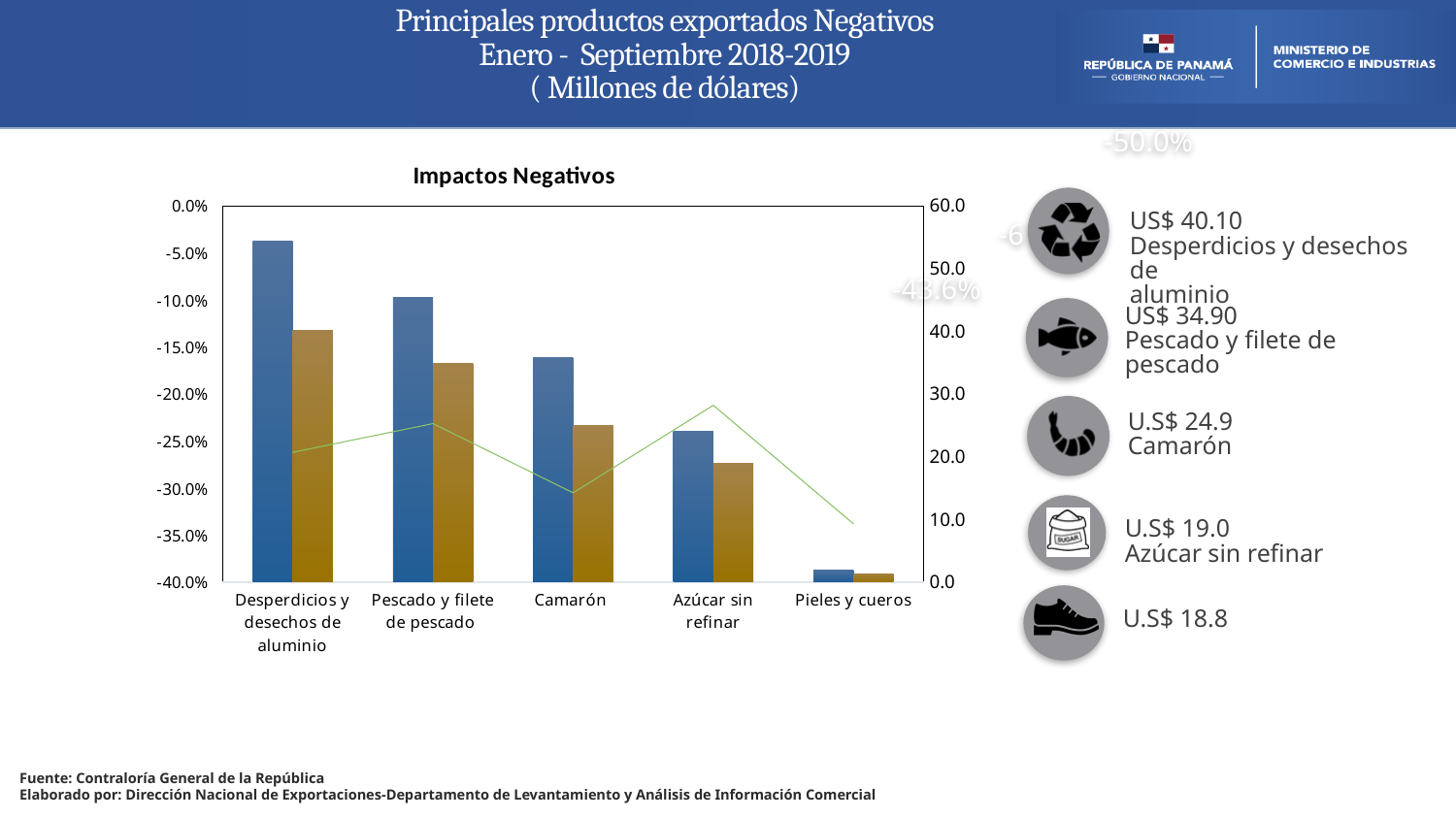
Do the blue bars rise or fall from left to right across the categories? fall What is the title of the chart on the slide? Impactos Negativos On the right-hand axis, is the gold bar for Desperdicios y desechos de aluminio greater or less than 30.0? greater How many product categories are shown on the x axis of the 'Impactos Negativos' chart? 5 On the right-hand axis, is the blue bar for Pieles y cueros greater or less than 10.0? less On the right-hand axis, is the blue bar for Camarón greater or less than 30.0? greater Which has the taller blue bar, Pescado y filete de pescado or Camarón? Pescado y filete de pescado Which category has the lowest point on the green line in the 'Impactos Negativos' chart? Pieles y cueros How many bars are shown for each category in the 'Impactos Negativos' chart? 2 Which category has the tallest blue bar in the 'Impactos Negativos' chart? Desperdicios y desechos de aluminio What kind of chart is shown under the title 'Impactos Negativos'? bar chart with a line Which category has the shortest blue bar in the 'Impactos Negativos' chart? Pieles y cueros